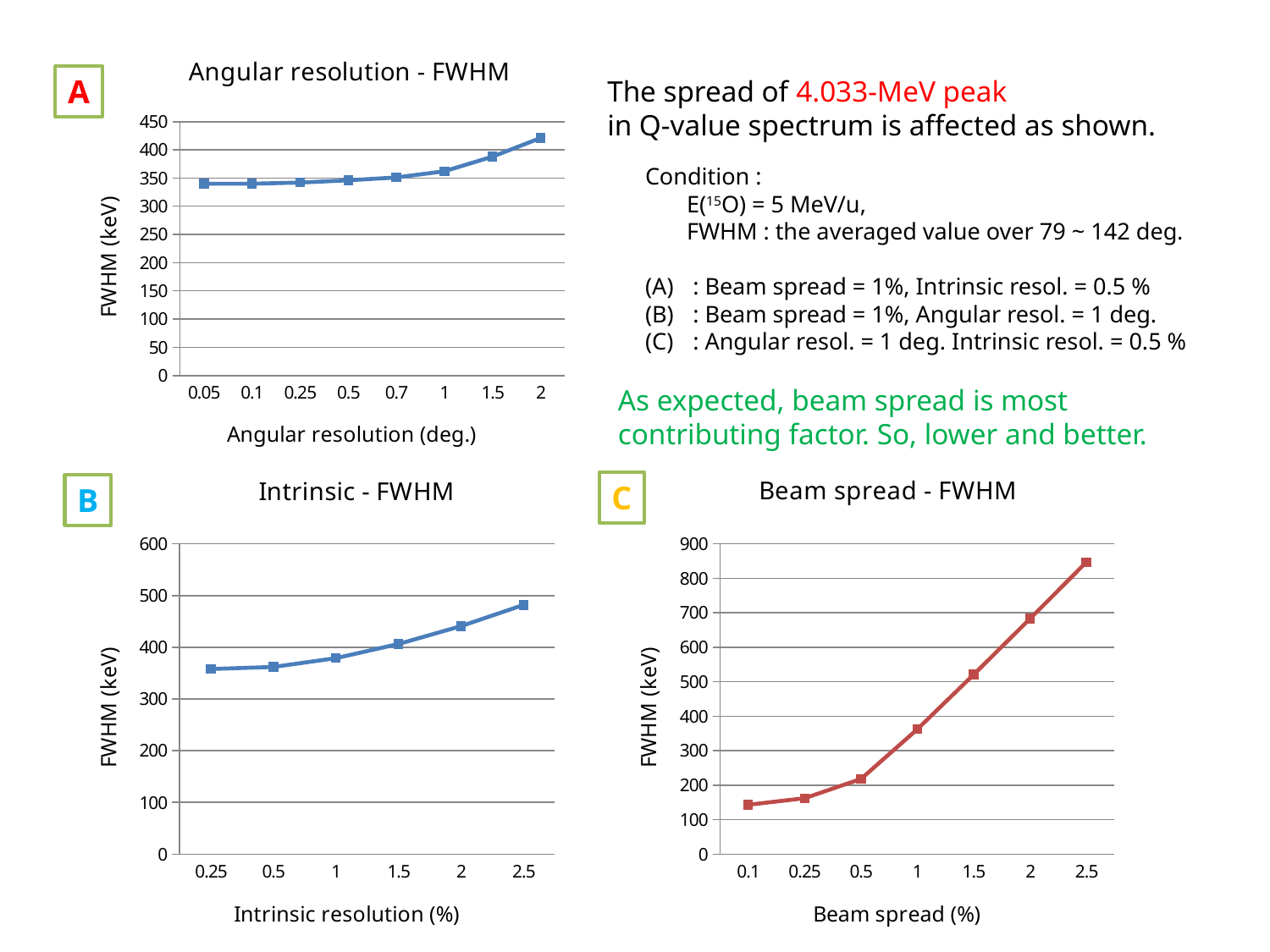
On the "Intrinsic - FWHM" chart, is the value at 2.5% greater or less than 500? less On the "Angular resolution - FWHM" chart, is the value at 2 deg. greater or less than 400? greater On the "Beam spread - FWHM" chart, is the value at 2.5% greater or less than 800? greater How many data points are plotted on the "Intrinsic - FWHM" chart? 6 What kind of chart is the "Angular resolution - FWHM" chart? line chart On the "Beam spread - FWHM" chart, which is larger, the value at 0.5% or the value at 1%? 1% What is the y-axis label of the "Beam spread - FWHM" chart? FWHM (keV) How many data points are plotted on the "Beam spread - FWHM" chart? 7 On the "Beam spread - FWHM" chart, which beam spread value has the highest FWHM? 2.5 How many data points are plotted on the "Angular resolution - FWHM" chart? 8 On the "Intrinsic - FWHM" chart, do the values rise or fall as intrinsic resolution increases? rise